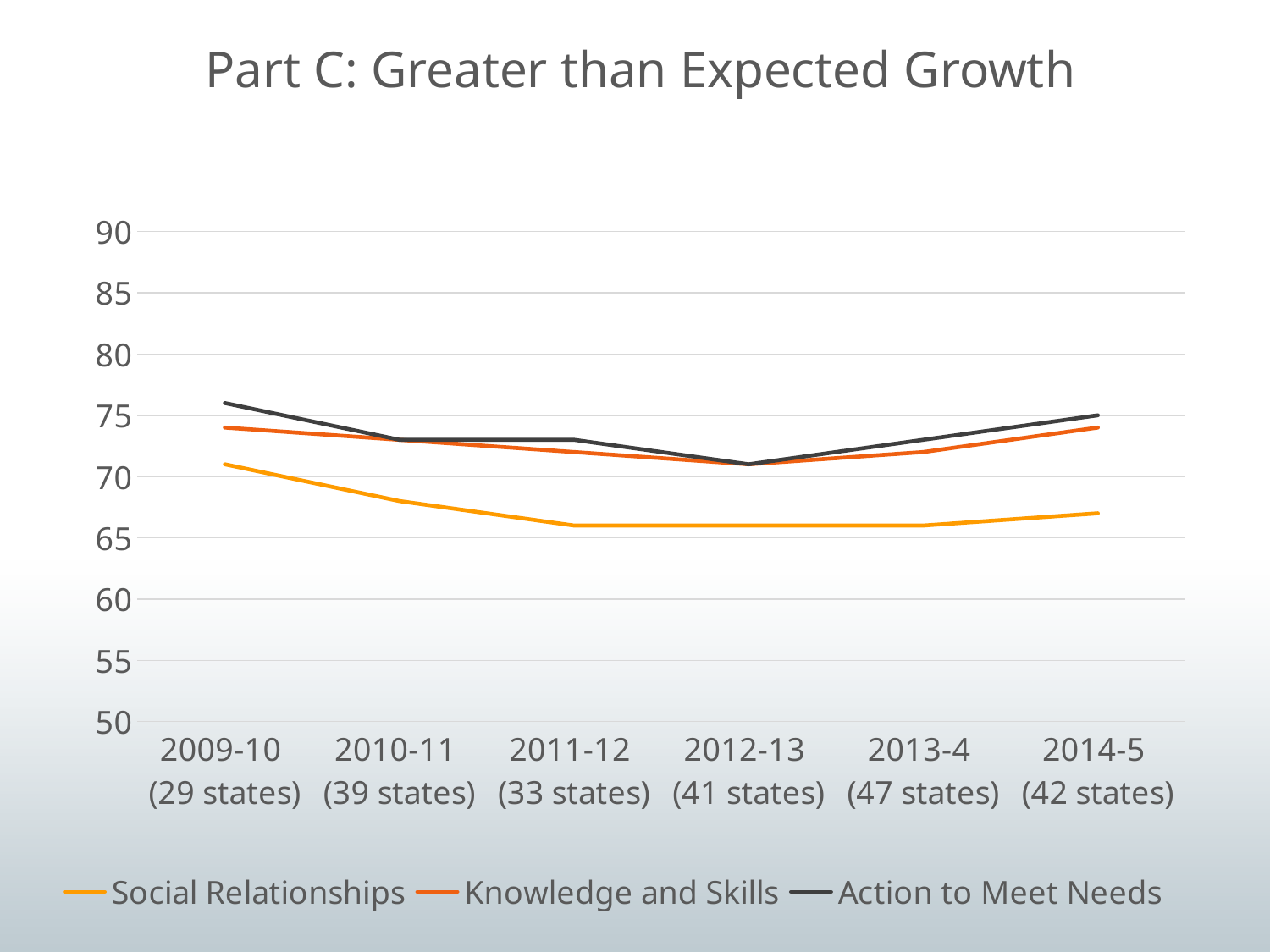
Does the Social Relationships line rise or fall from 2009-10 to 2011-12? fall How many series does the legend list? 3 Is the value for Social Relationships in 2014-5 greater or less than 65? greater What kind of chart is shown on the slide? line chart In 2010-11, which is higher: Social Relationships or Knowledge and Skills? Knowledge and Skills How many time periods are shown along the x axis? 6 Which series has the highest value in 2009-10? Action to Meet Needs Which series has the lowest value in 2011-12? Social Relationships Which series is drawn in the yellow line? Social Relationships Is the value for Social Relationships in 2011-12 greater or less than 70? less Is the value for Action to Meet Needs in 2009-10 greater or less than 80? less What is the title of the chart? Part C: Greater than Expected Growth